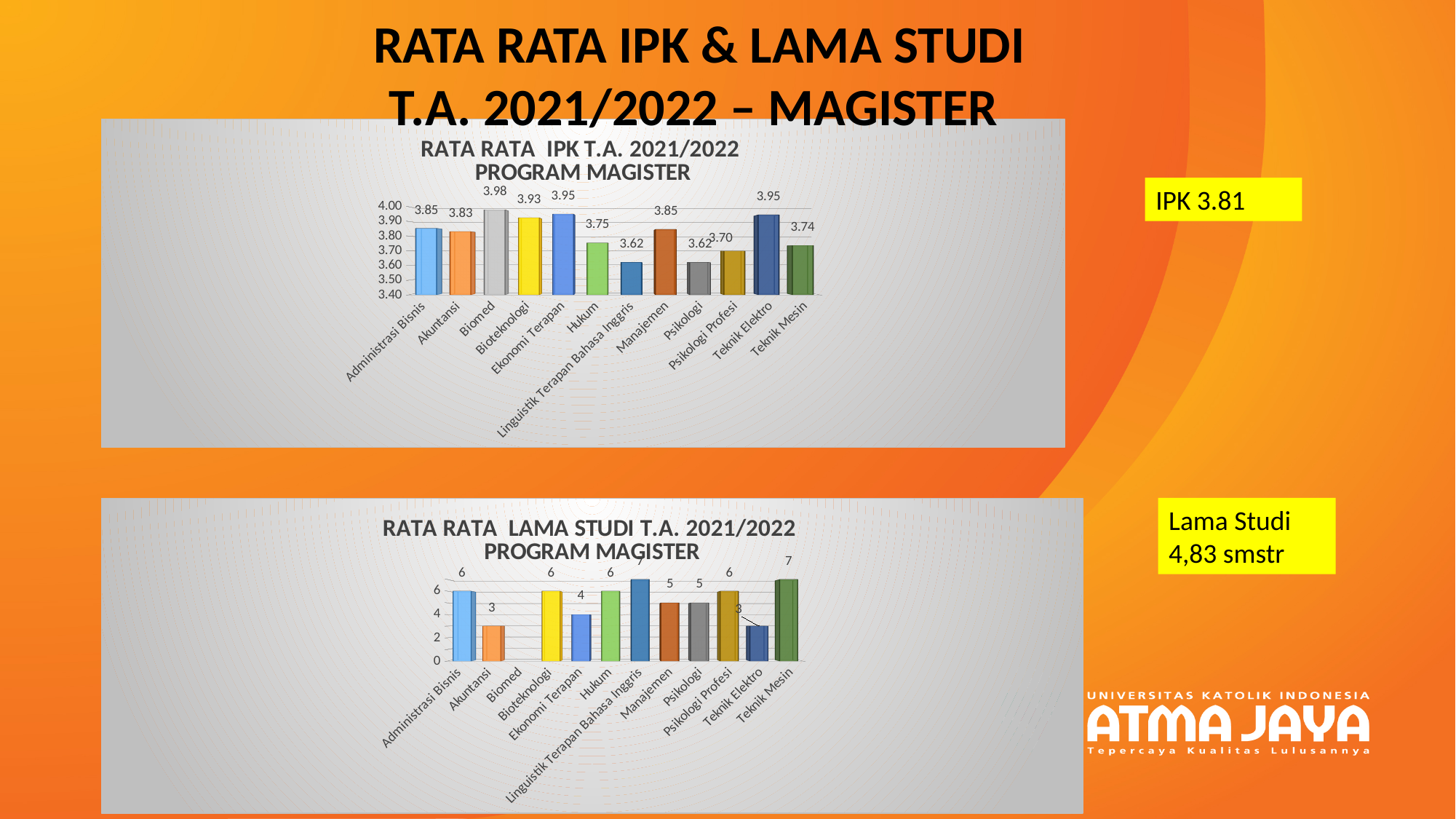
In the top chart (RATA RATA IPK T.A. 2021/2022 PROGRAM MAGISTER), what is the value for Biomed? 3.98 What is the title of the top chart on the slide? RATA RATA IPK T.A. 2021/2022 PROGRAM MAGISTER In the top chart (RATA RATA IPK T.A. 2021/2022 PROGRAM MAGISTER), which is larger: Bioteknologi or Ekonomi Terapan? Ekonomi Terapan In the top chart (RATA RATA IPK T.A. 2021/2022 PROGRAM MAGISTER), how many programs are listed on the x axis? 12 In the top chart (RATA RATA IPK T.A. 2021/2022 PROGRAM MAGISTER), what is the value for Hukum? 3.75 What kind of chart is the bottom chart (RATA RATA LAMA STUDI T.A. 2021/2022 PROGRAM MAGISTER)? Bar chart In the bottom chart (RATA RATA LAMA STUDI T.A. 2021/2022 PROGRAM MAGISTER), what is the value for Ekonomi Terapan? 4 In the bottom chart (RATA RATA LAMA STUDI T.A. 2021/2022 PROGRAM MAGISTER), which is larger: Manajemen or Psikologi Profesi? Psikologi Profesi In the bottom chart (RATA RATA LAMA STUDI T.A. 2021/2022 PROGRAM MAGISTER), what is the value for Linguistik Terapan Bahasa Inggris? 7 In the top chart (RATA RATA IPK T.A. 2021/2022 PROGRAM MAGISTER), which program has the highest value? Biomed In the top chart (RATA RATA IPK T.A. 2021/2022 PROGRAM MAGISTER), what is the difference between the values for Biomed and Psikologi Profesi? 0.28 In the bottom chart (RATA RATA LAMA STUDI T.A. 2021/2022 PROGRAM MAGISTER), what is the difference between the values for Teknik Mesin and Teknik Elektro? 4